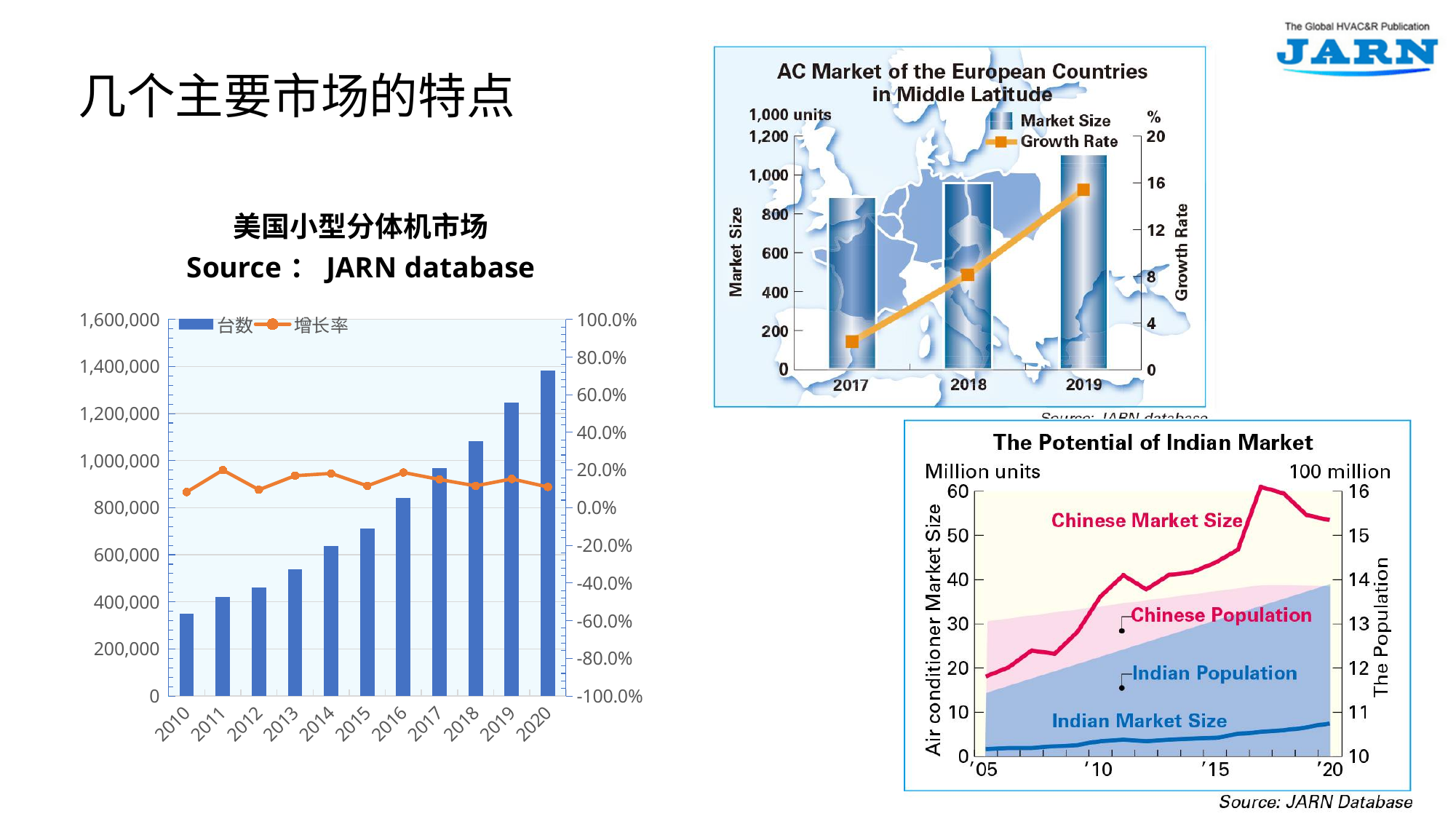
In the 美国小型分体机市场 chart on the left, is the 台数 value for 2010 greater or less than 400,000? less In the 'AC Market of the European Countries in Middle Latitude' chart, is the Growth Rate for 2019 greater or less than 12%? greater In the 美国小型分体机市场 chart on the left, how many years are shown on the x axis? 11 In the 美国小型分体机市场 chart on the left, do the 台数 bars rise or fall from 2010 to 2020? rise In the 美国小型分体机市场 chart on the left, is the 台数 value for 2020 greater or less than 1,200,000? greater In the 'AC Market of the European Countries in Middle Latitude' chart, does the Growth Rate rise or fall from 2017 to 2019? rise In the 美国小型分体机市场 chart on the left, how many series does the legend list? 2 In 'The Potential of Indian Market' chart, which is larger in '20, the Chinese Market Size or the Indian Market Size? Chinese Market Size In the 美国小型分体机市场 chart on the left, which year has the lowest 台数 bar? 2010 In the 'AC Market of the European Countries in Middle Latitude' chart, which year has the largest Market Size bar? 2019 In the 美国小型分体机市场 chart on the left, which year has the highest 台数 bar? 2020